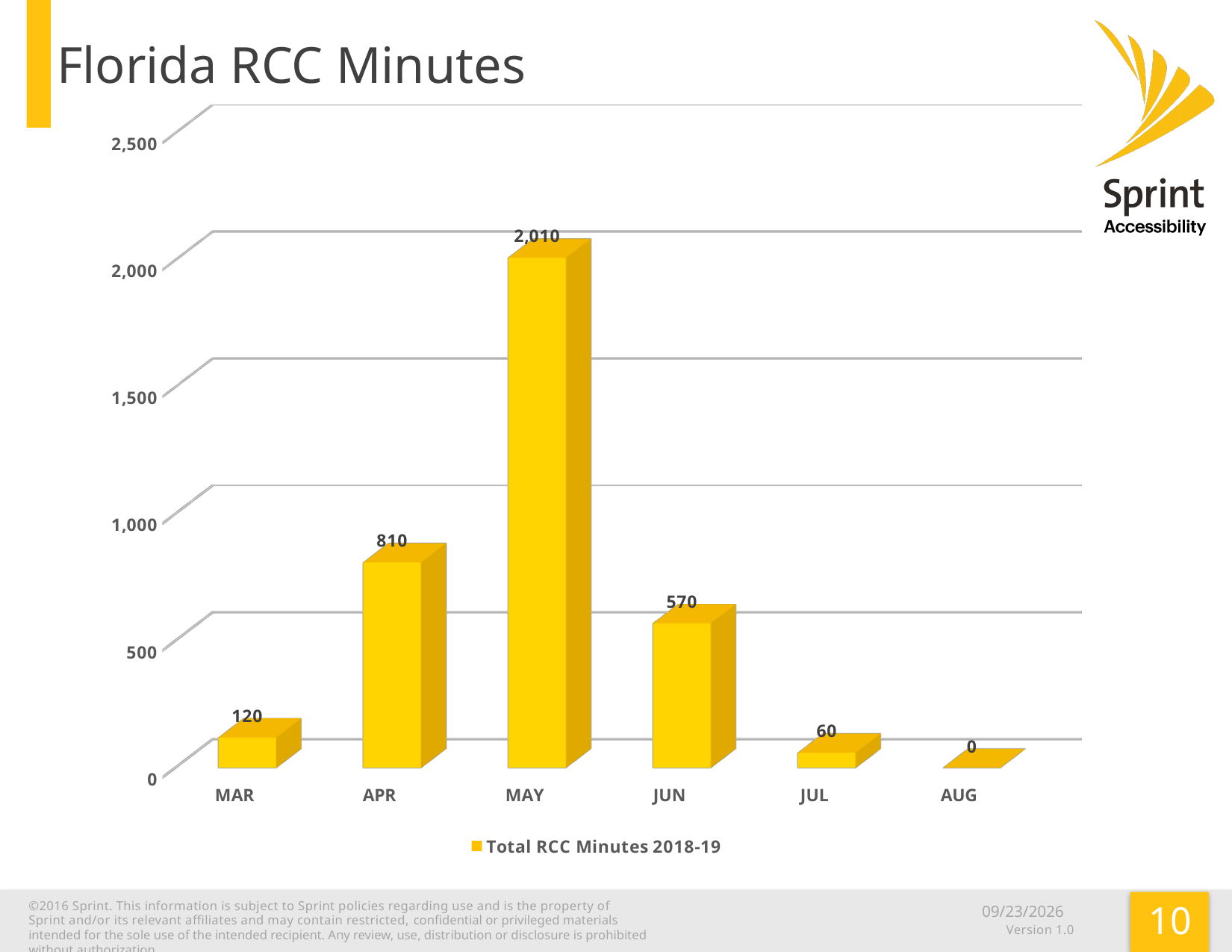
What is the legend entry for the series shown? Total RCC Minutes 2018-19 Which is larger, the value for APR or the value for JUN? APR What is the difference between the values for JUN and MAR? 450 Is the value for MAY greater or less than 1,500? greater How many months are shown on the x axis? 6 Which month has the lowest value? AUG Which month has the highest value? MAY What is the value for MAY? 2,010 What is the value for APR? 810 What is the difference between the values for MAY and APR? 1,200 What is the value for JUL? 60 What kind of chart is shown on the slide? bar chart